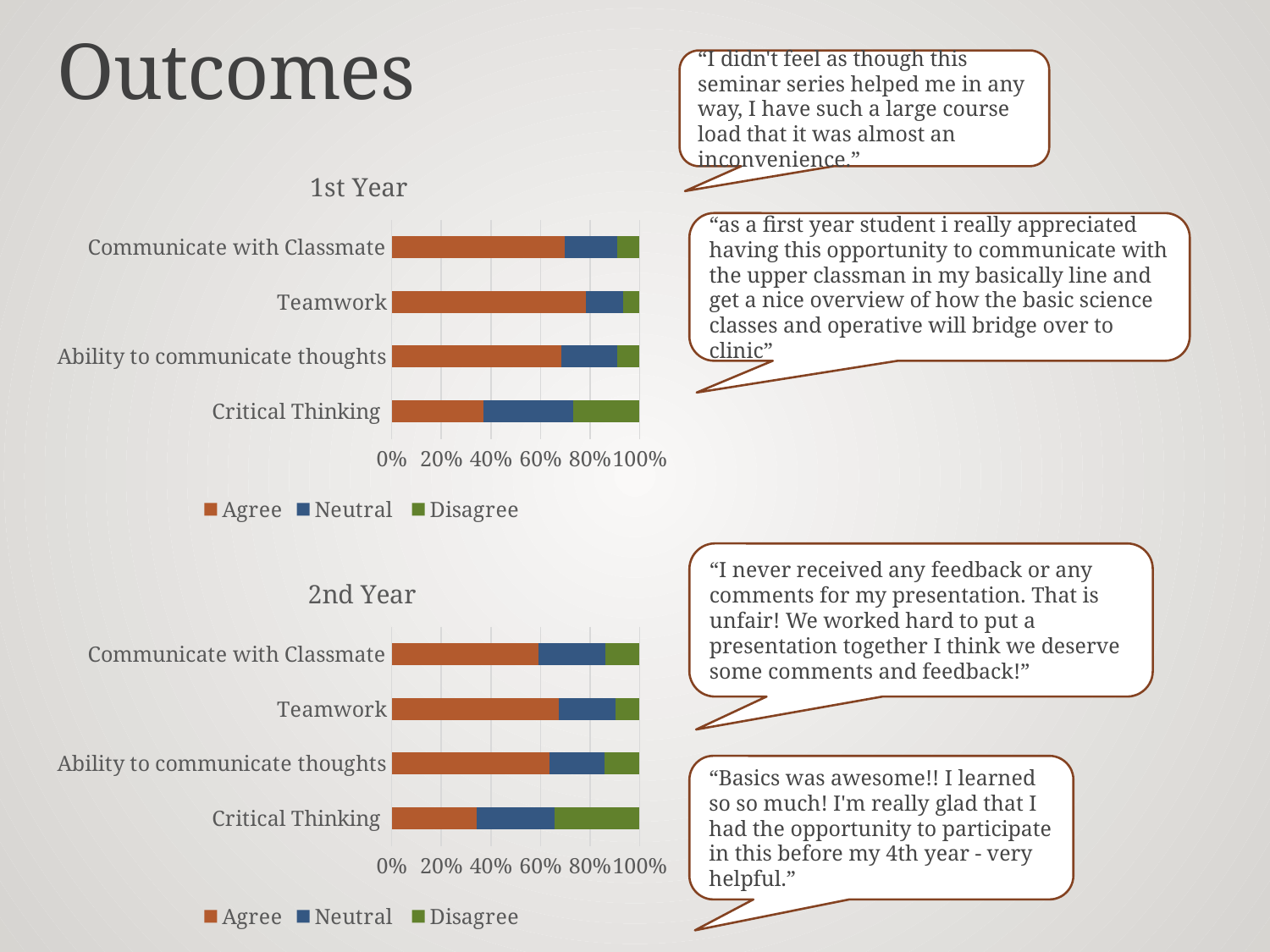
In the 1st Year chart, which category has the largest Agree segment? Teamwork What are the three legend entries of the 1st Year chart? Agree, Neutral, Disagree In the 2nd Year chart, which category has the smallest Agree segment? Critical Thinking In the 1st Year chart, is the Agree value for Critical Thinking greater or less than 60%? less In the 2nd Year chart, is the Agree value for Communicate with Classmate greater or less than 40%? greater In the 2nd Year chart, which category has the largest Disagree segment? Critical Thinking In the 1st Year chart, is the Agree value for Teamwork greater or less than 60%? greater What kind of chart is the 1st Year chart? Stacked bar chart In the 1st Year chart, which category has the smallest Agree segment? Critical Thinking How many series does the legend of the 2nd Year chart list? 3 In the 1st Year chart, which has the larger Agree segment: Teamwork or Critical Thinking? Teamwork How many categories does the 1st Year chart show? 4